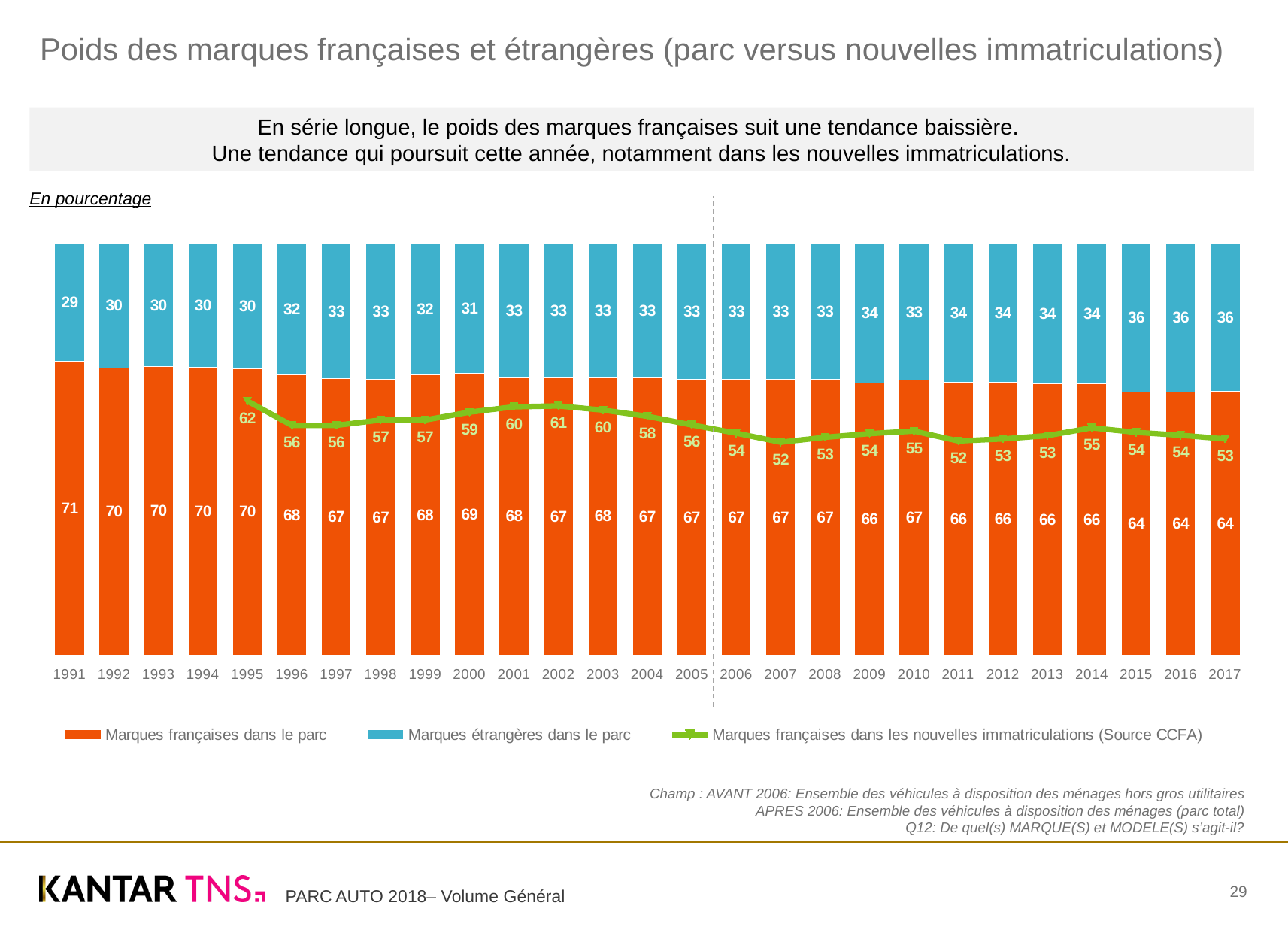
In which year is Marques françaises dans les nouvelles immatriculations highest? 1995 What is the value for Marques françaises dans les nouvelles immatriculations in 1995? 62 In which year is Marques étrangères dans le parc lowest? 1991 What is the value for Marques françaises dans les nouvelles immatriculations in 2017? 53 What is the value for Marques françaises dans le parc in 1991? 71 In which year is Marques françaises dans le parc highest? 1991 How many series does the legend list? 3 Does Marques françaises dans le parc rise or fall from 1991 to 2017? fall Which is larger: Marques françaises dans les nouvelles immatriculations in 2002 or in 2007? 2002 What is the value for Marques étrangères dans le parc in 2017? 36 How many years are shown on the x axis? 27 What is the difference between Marques françaises dans le parc in 1991 and in 2017? 7